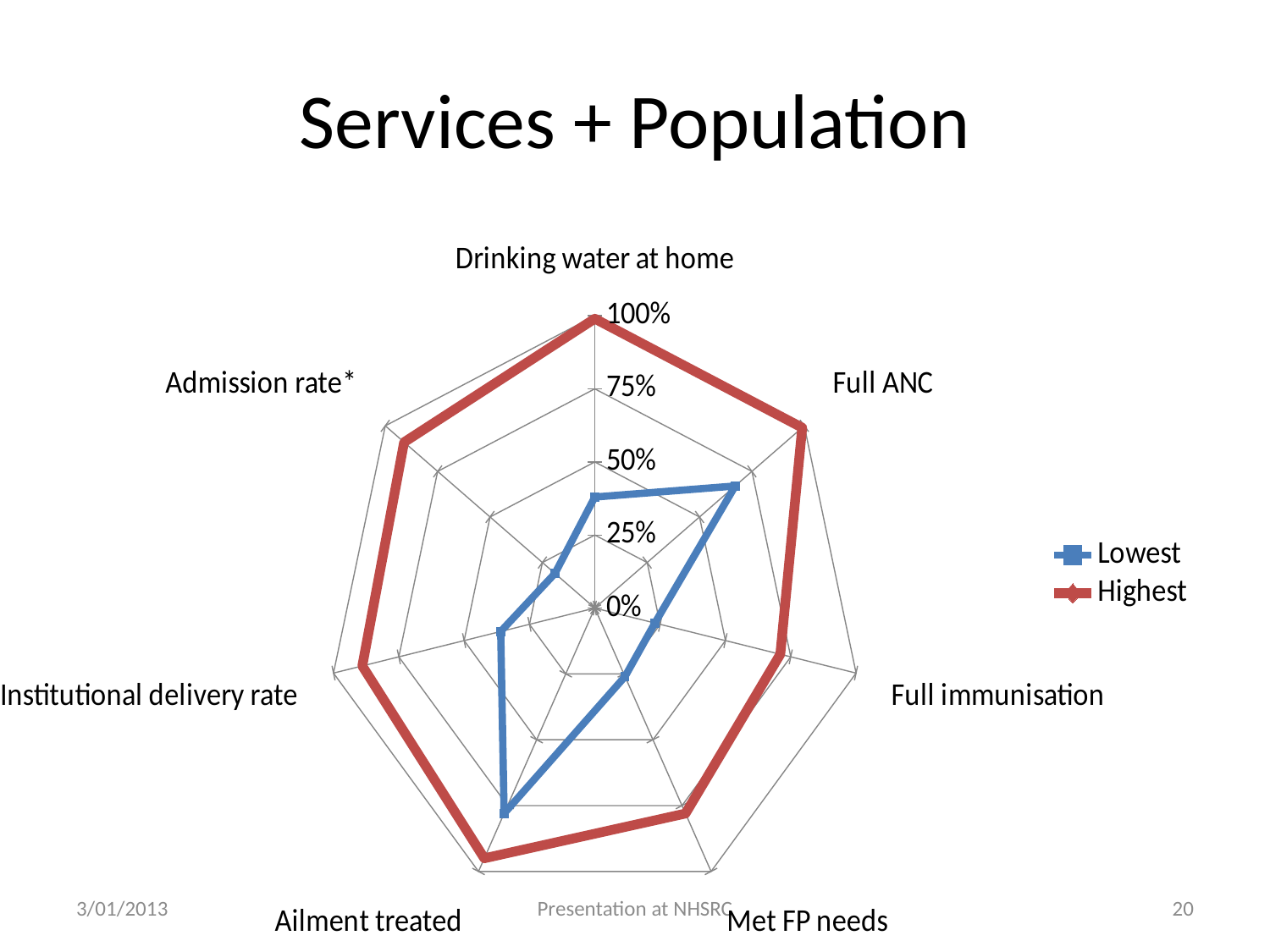
Is the Highest value for Met FP needs greater or less than 50%? greater How many categories (axes) does the radar chart have? 7 Is the Lowest value for Full ANC greater or less than 50%? greater Is the Highest value for Institutional delivery rate greater or less than 75%? greater What kind of chart is shown on the slide? Radar chart What is the title of the slide containing the chart? Services + Population How many series does the legend list? 2 For Ailment treated, which series has the larger value: Lowest or Highest? Highest Which series is drawn in red? Highest For the Lowest series, which is larger: Full ANC or Full immunisation? Full ANC